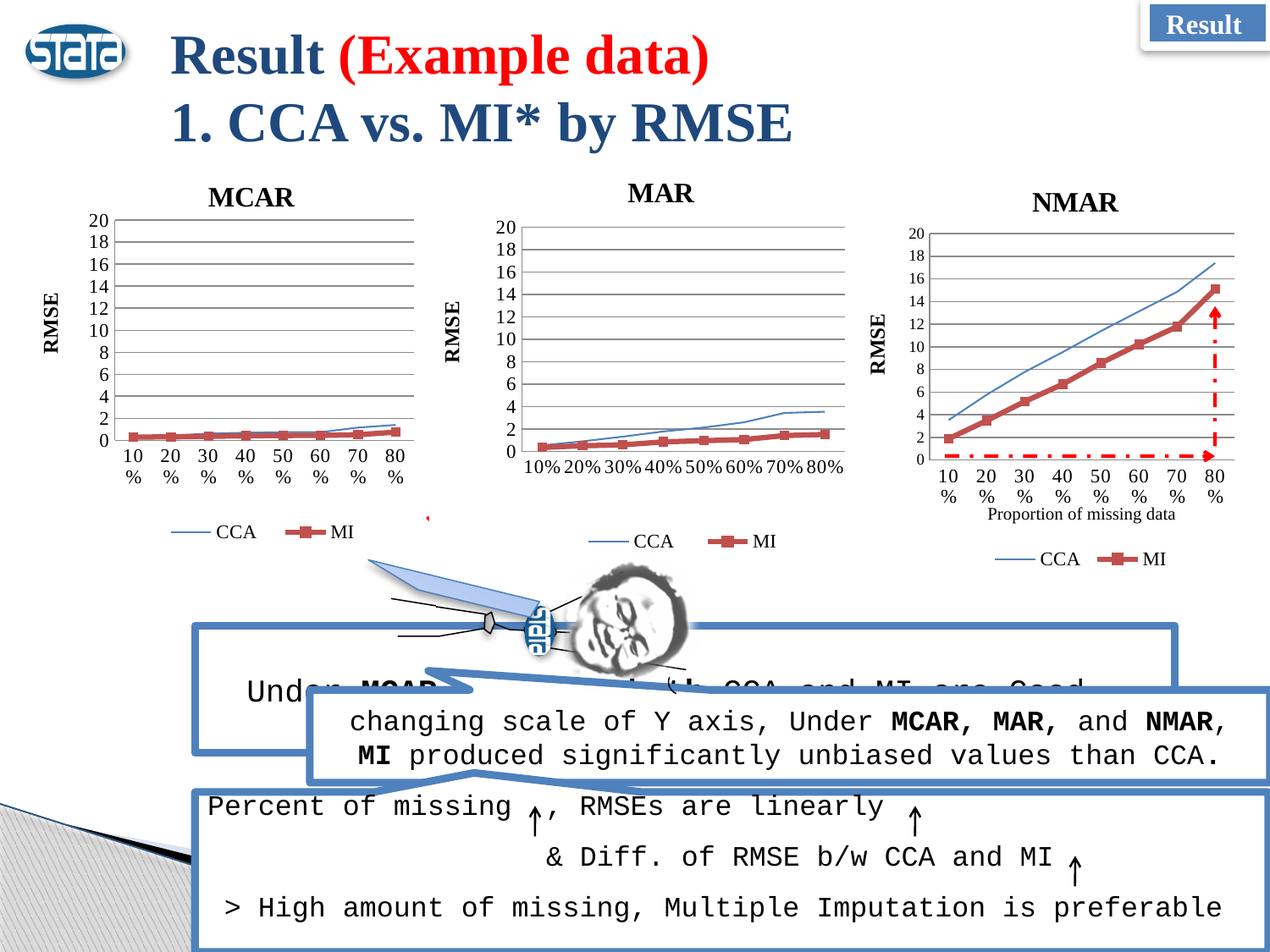
How many proportion-of-missing-data points are plotted along the x axis of the MAR chart? 8 In the MAR chart, is the CCA value at 80% greater or less than 6? less In the NMAR chart, which series has the larger value at 80%, CCA or MI? CCA How many series does the legend of the NMAR chart list? 2 In the MCAR chart, is the CCA value at 80% greater or less than 4? less In the NMAR chart, does the MI series rise or fall as the proportion of missing data increases from 10% to 80%? rises In the NMAR chart, is the CCA value at 80% greater or less than 16? greater What is the y-axis title of the MAR chart? RMSE In the MAR chart, which series has the larger value at 80%, CCA or MI? CCA What kind of chart is the MCAR chart? line chart